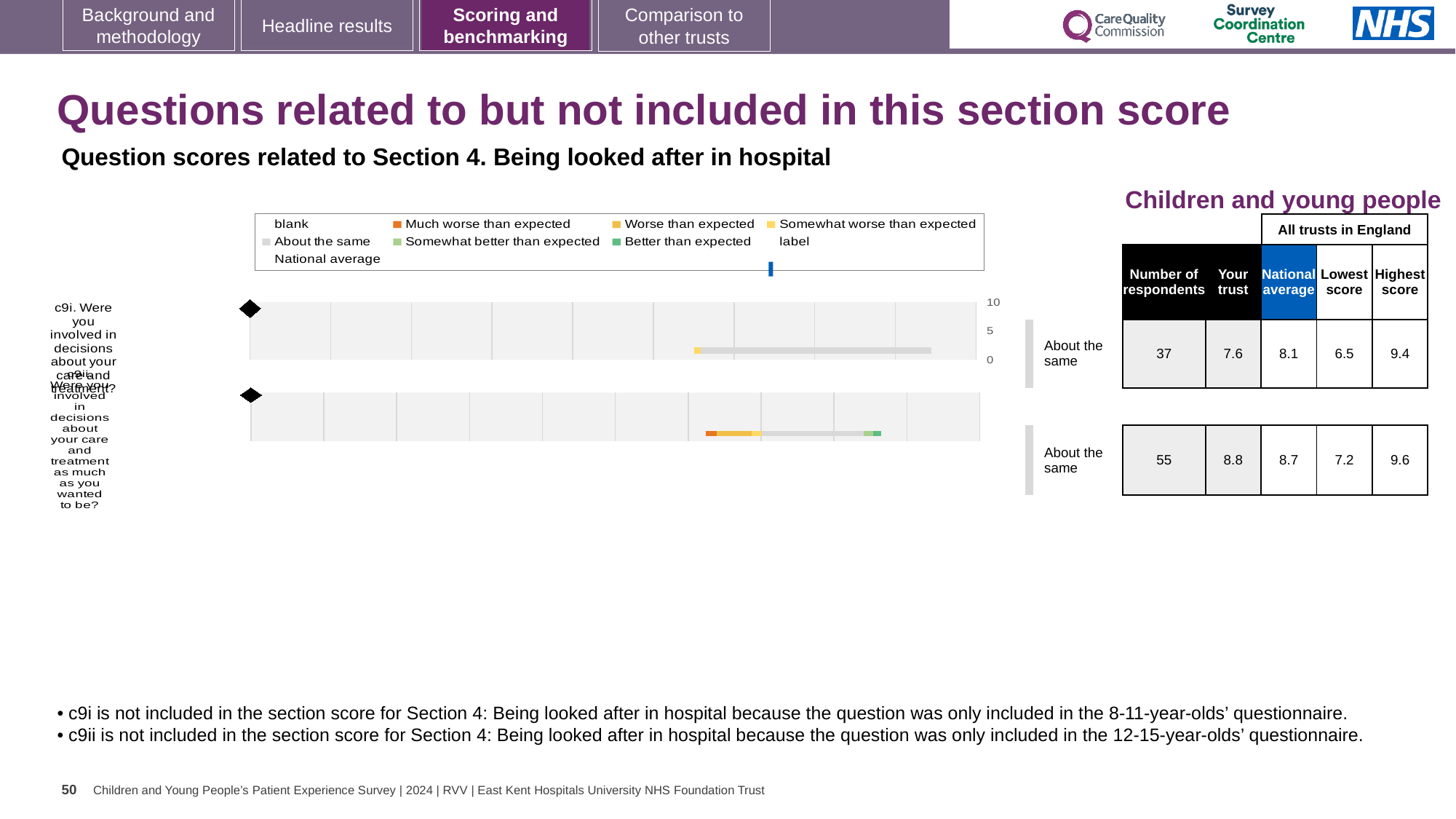
In the table beside the charts, what is the national average for c9ii? 8.7 What benchmark category is shown next to the c9i chart? About the same In the table beside the charts, which question has the higher 'Your trust' score, c9i or c9ii? c9ii How many question charts are shown on the slide? 2 What is the highest value shown on the vertical axis of the question charts? 10 What kind of chart is used for the c9i and c9ii question scores? bar chart In the table beside the charts, what is the 'Your trust' score for c9i? 7.6 In the table beside the charts, how many respondents answered c9ii? 55 Which legend entry is shown in dark orange in the question charts? Much worse than expected What benchmark category is shown next to the c9ii chart? About the same In the table beside the charts, what is the 'Your trust' score for c9ii? 8.8 In the table beside the charts, what is the difference between the highest score and lowest score for c9i? 2.9